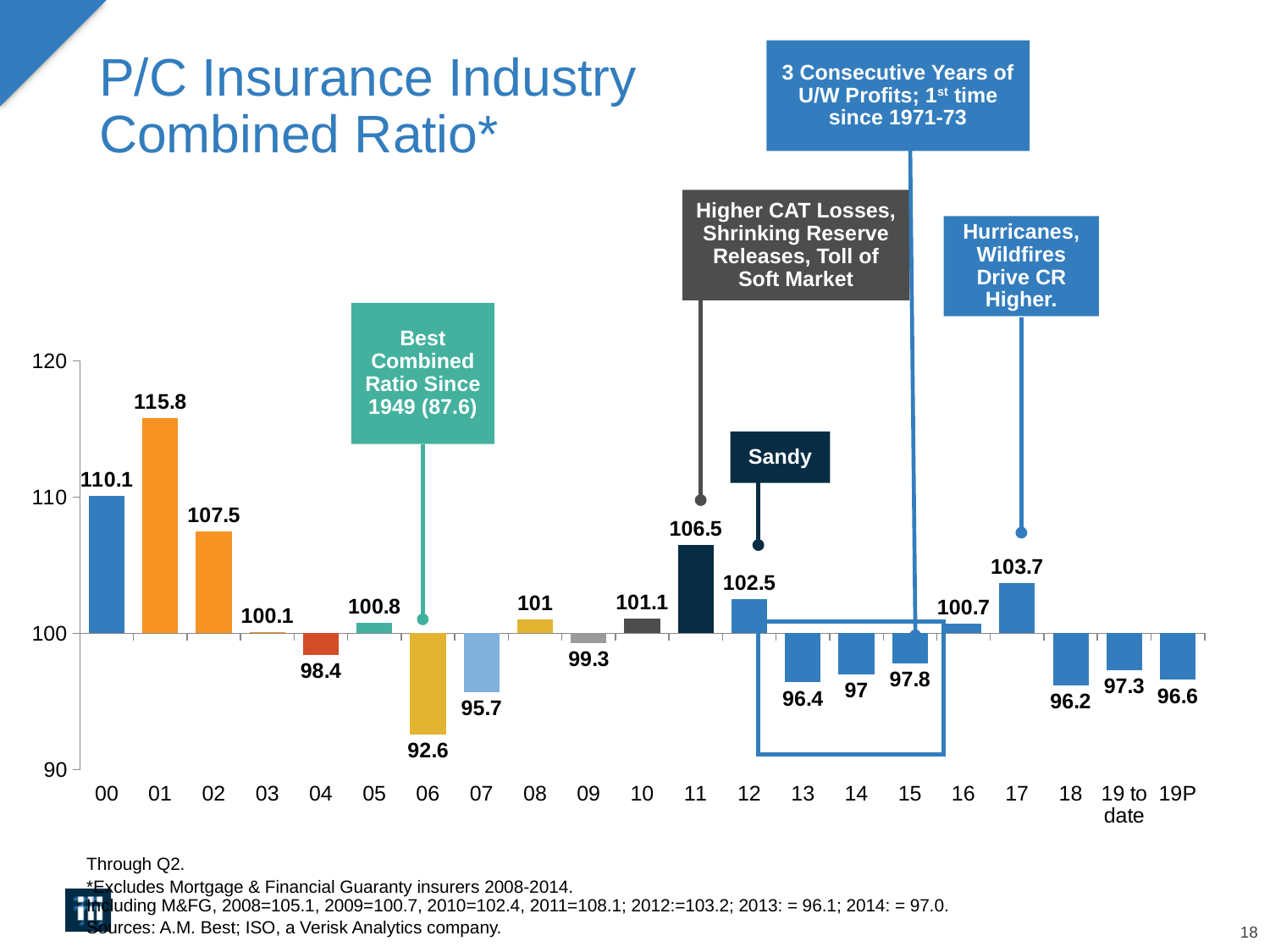
According to the callout on the chart, what event is labeled for 2012? Sandy Which year has the lowest combined ratio on the chart? 06 Which year has the highest combined ratio on the chart? 01 What type of chart is shown on the slide? Bar chart How many bars (years/periods) are plotted on the chart? 21 Do the combined ratio values rise or fall from 2000 to 2006? Fall What is the combined ratio shown for 2017? 103.7 What is the combined ratio shown for 2001? 115.8 What is the combined ratio shown for 19P? 96.6 What is the combined ratio shown for 2006? 92.6 Which is larger, the combined ratio for 2000 or for 2002? 2000 What is the difference between the combined ratio for 2011 and for 2012? 4